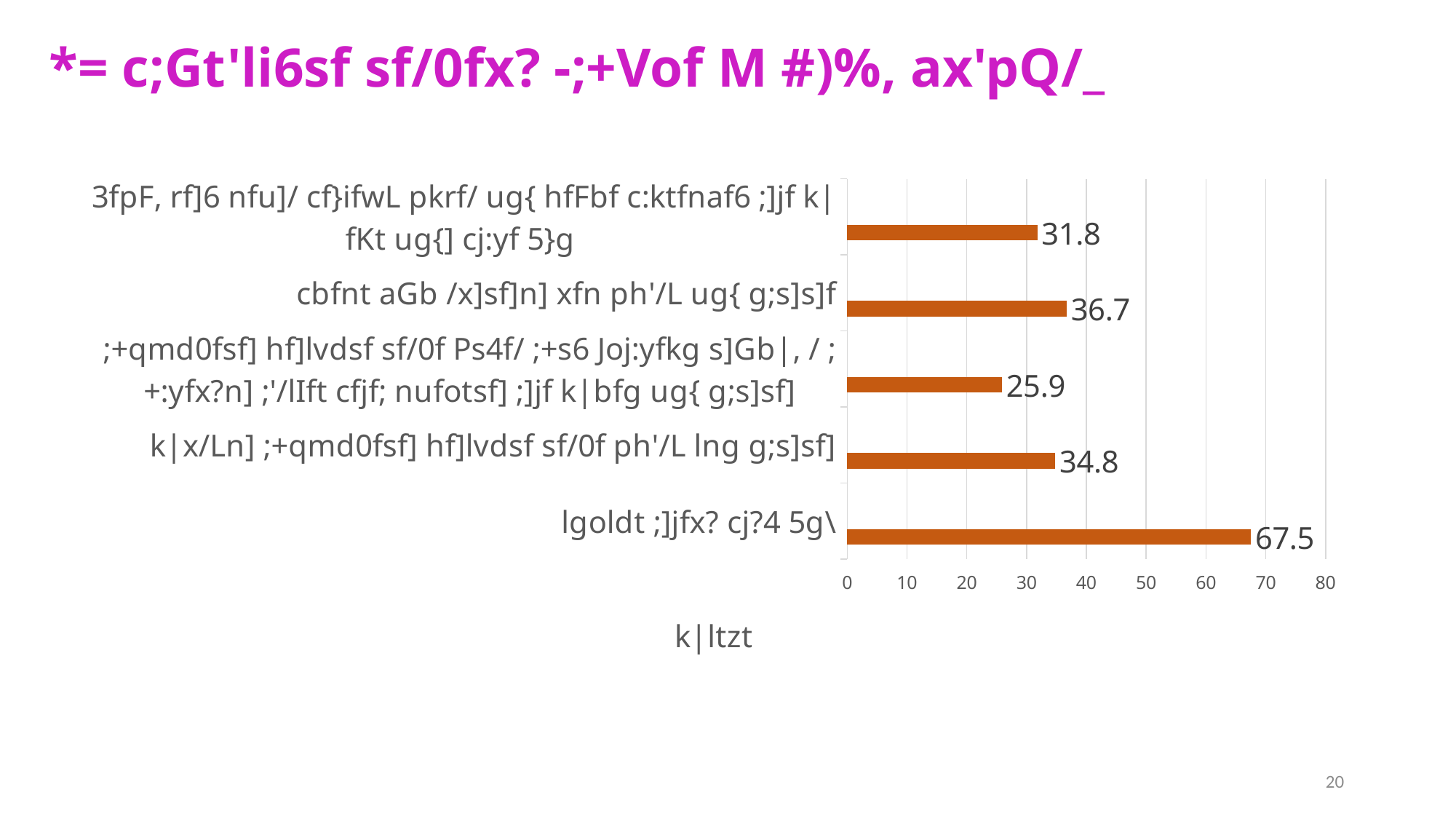
How many bars (categories) does the chart show? 5 What is the value of the bottom bar, labelled "lgoldt ;]jfx? cj?4 5g\"? 67.5 Which is larger: the value for "cbfnt aGb /x]sf]n] xfn ph'/L ug{ g;s]s]f" or the value for the topmost bar? cbfnt aGb /x]sf]n] xfn ph'/L ug{ g;s]s]f What is the difference between the highest value (67.5) and the lowest value (25.9)? 41.6 What is the value of the bar labelled "k|x/Ln] ;+qmd0fsf] hf]lvdsf sf/0f ph'/L lng g;s]sf]"? 34.8 What is the maximum value shown on the horizontal axis? 80 What is the value of the topmost bar in the chart? 31.8 What kind of chart is shown on the slide? bar chart What is the title of the horizontal axis? k|ltzt What is the value of the bar labelled "cbfnt aGb /x]sf]n] xfn ph'/L ug{ g;s]s]f"? 36.7 Which bar has the highest value? lgoldt ;]jfx? cj?4 5g\ What is the lowest value shown in the chart? 25.9